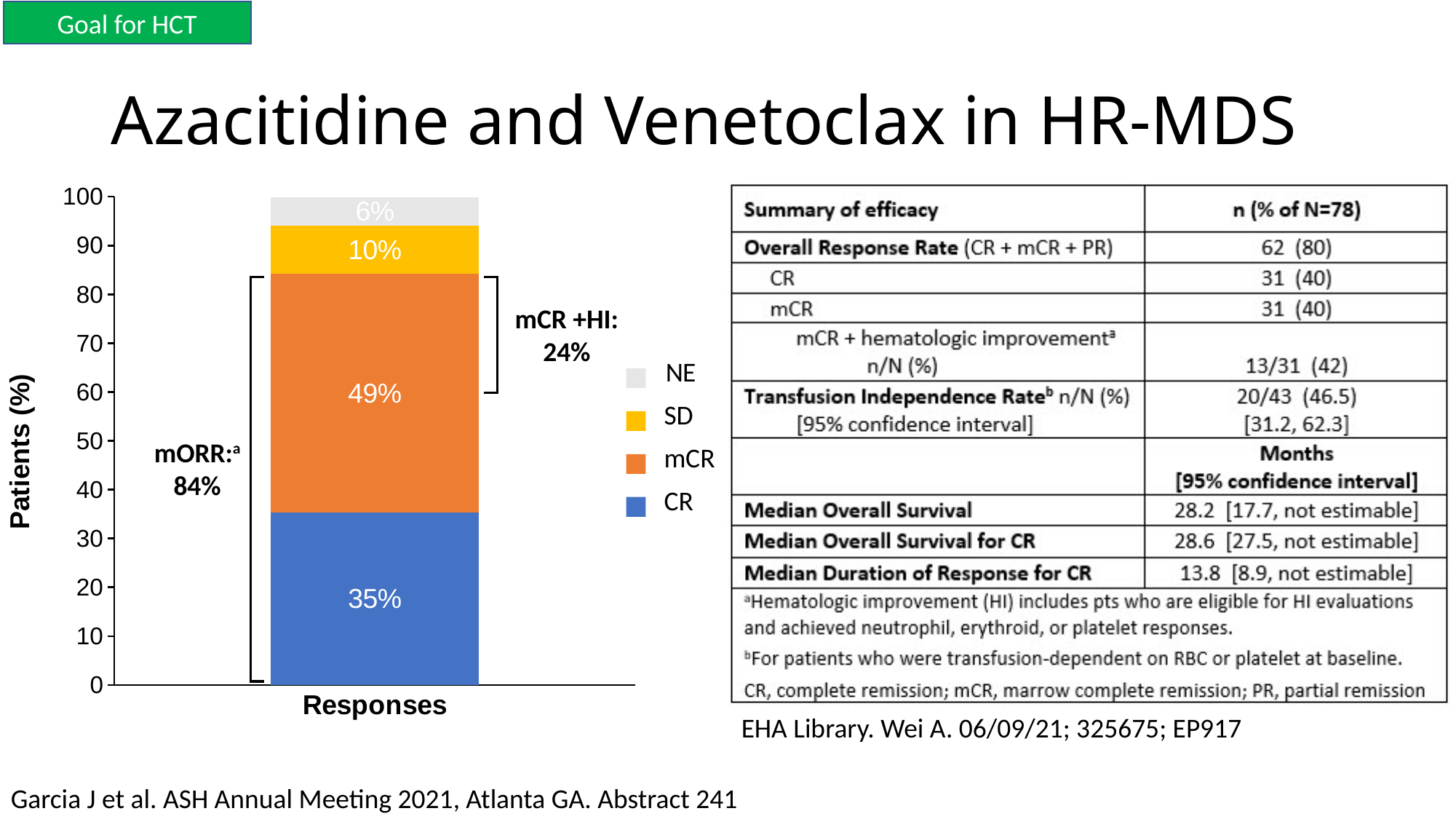
Which response category has the largest segment in the stacked bar? mCR What percentage of patients were NE in the stacked bar chart? 6% How many series does the chart legend list? 4 What is the y-axis label of the bar chart? Patients (%) What type of chart is shown on the left of the slide? Stacked bar chart What is the combined total of the CR and mCR segments, labelled as mORR on the chart? 84% What percentage of patients achieved mCR in the stacked bar chart? 49% Which response category has the smallest segment in the stacked bar? NE What is the difference between the mCR and CR percentages in the stacked bar? 14% Which is larger in the stacked bar, the SD segment or the NE segment? SD What percentage of patients had SD in the stacked bar chart? 10% What percentage of patients achieved CR in the stacked bar chart? 35%